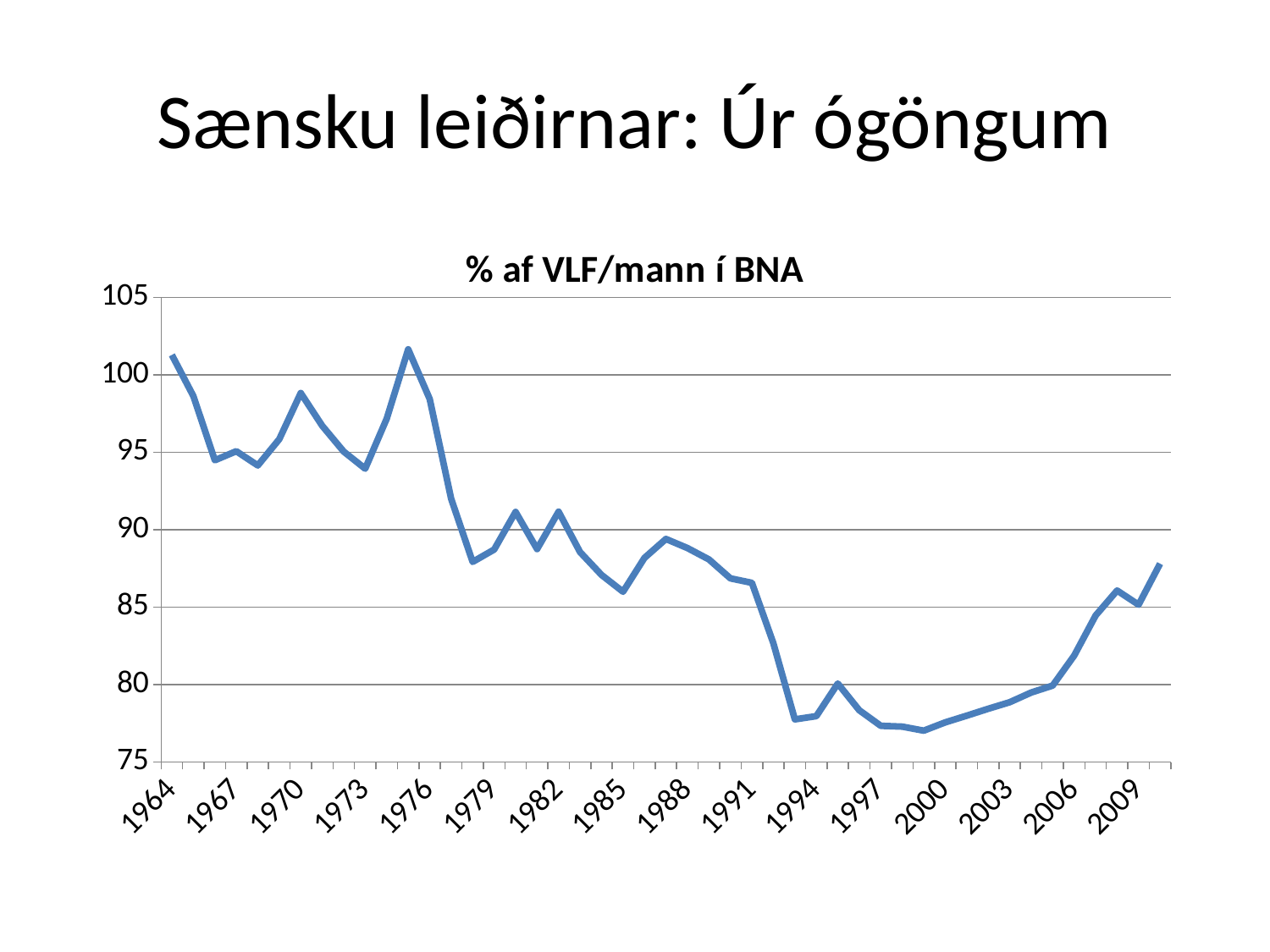
Is the value for 1985 greater or less than 90? less What kind of chart is shown on the slide? line chart Is the value for 1970 greater or less than 95? greater Is the value for 1994 greater or less than 80? less What is the title of the chart? % af VLF/mann í BNA Which year has the larger value, 1964 or 2009? 1964 Overall, do the values rise or fall from 1964 to 2009? fall Which year has the larger value, 1970 or 1994? 1970 What is the range of the vertical axis? 75 to 105